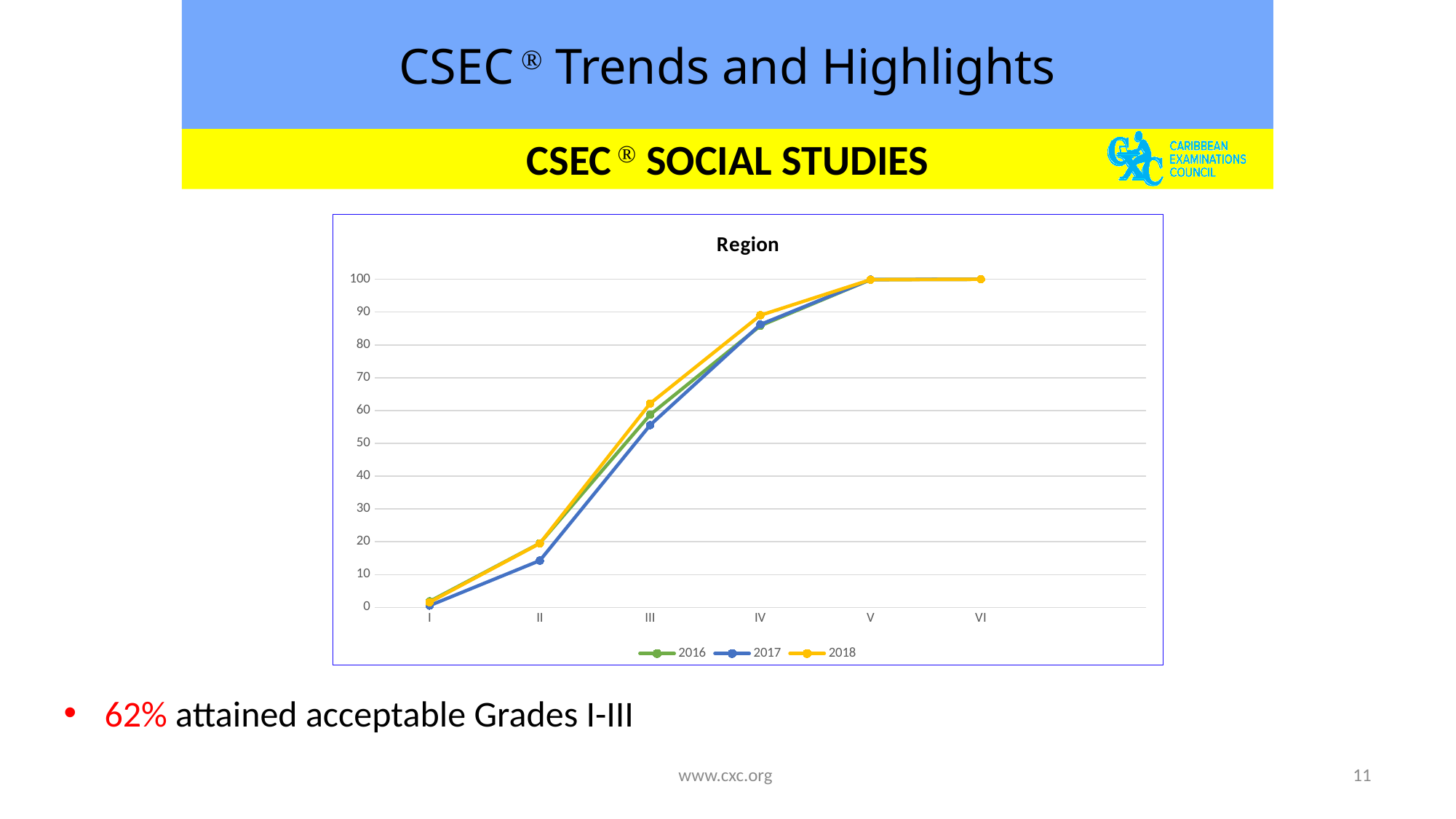
Which years are listed in the chart legend? 2016, 2017, 2018 How many grade categories are shown on the x axis? 6 Is the value for 2017 at Grade III greater or less than 60? less Is the value for 2017 at Grade II greater or less than 20? less At Grade II, which series has the larger value, 2017 or 2018? 2018 Do the values rise or fall from Grade I to Grade VI? rise How many series does the legend list? 3 Is the value for 2018 at Grade IV greater or less than 80? greater What is the value for 2017 at Grade VI? 100 What is the title of the chart? Region What kind of chart is shown on the slide? line chart